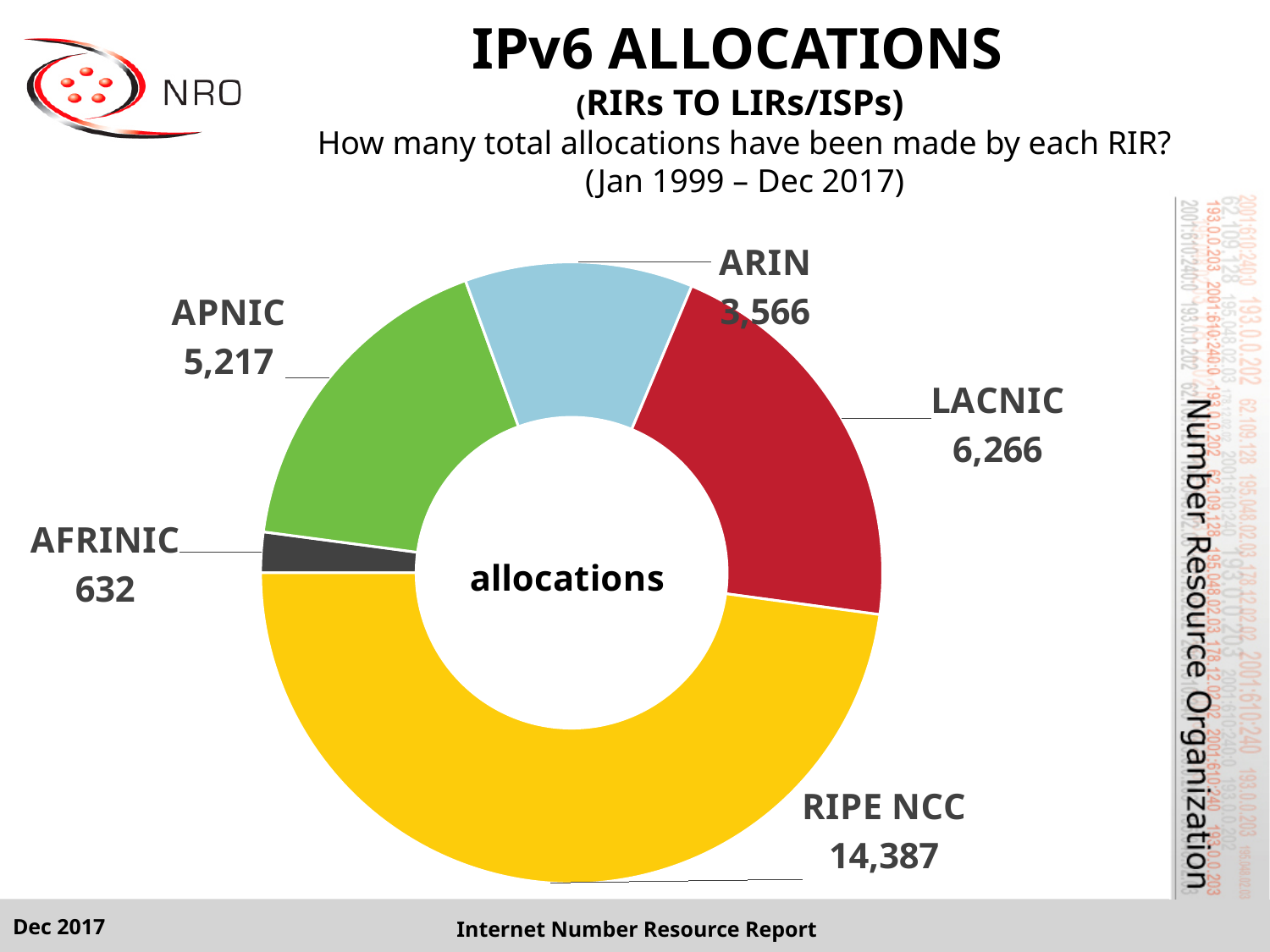
Which has more allocations, LACNIC or APNIC? LACNIC What is the difference between the allocations of LACNIC and APNIC? 1,049 What type of chart is shown on the slide? Donut (pie) chart How many more allocations has RIPE NCC made than LACNIC? 8,121 Which RIR has made the fewest IPv6 allocations? AFRINIC How many RIRs are shown in the chart? 5 What is the value shown for LACNIC? 6,266 What colour is the RIPE NCC segment of the chart? Yellow What is the value shown for AFRINIC? 632 What is the value shown for APNIC? 5,217 How many IPv6 allocations has RIPE NCC made according to the chart? 14,387 Which RIR has made the most IPv6 allocations? RIPE NCC